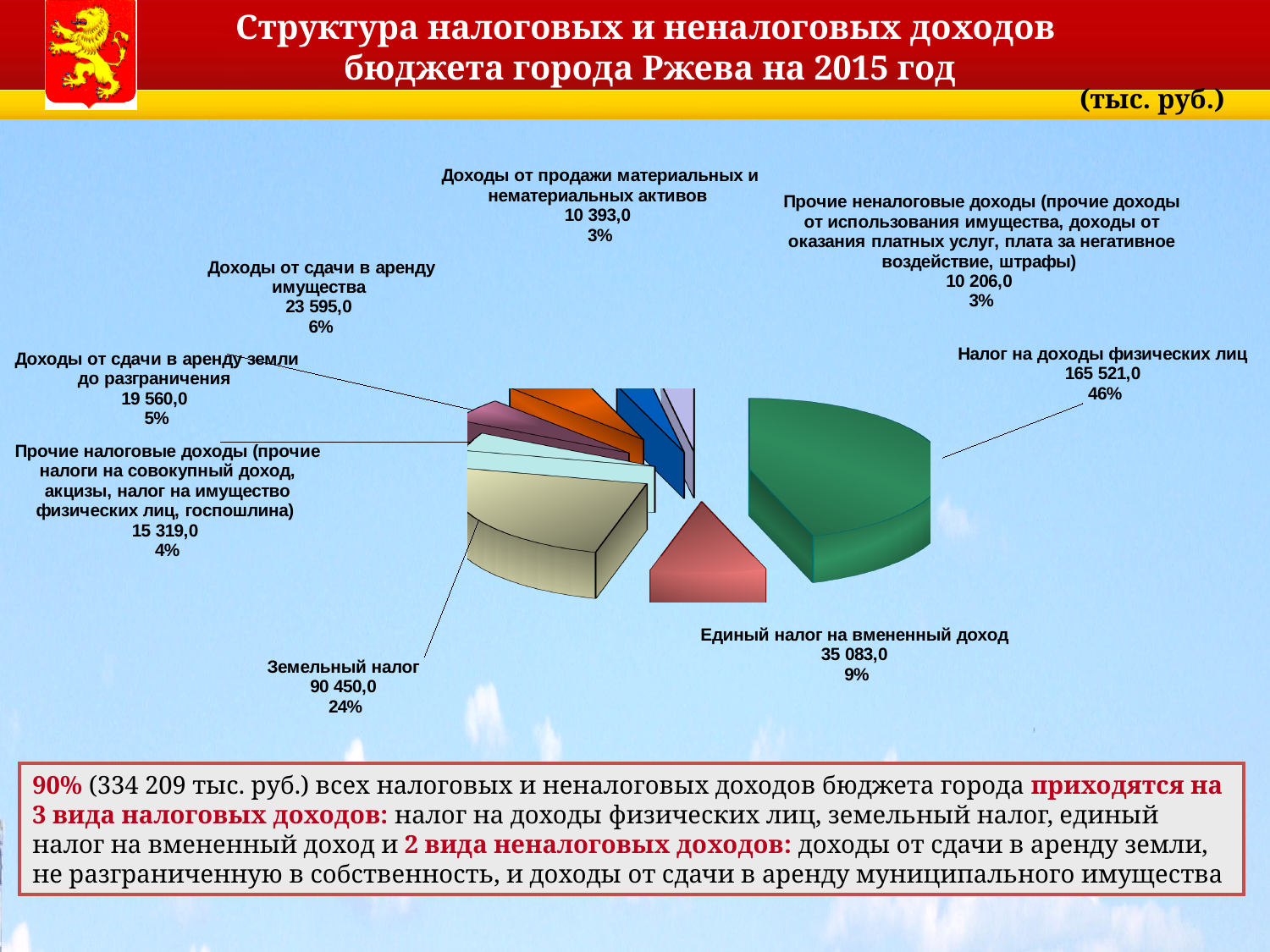
What type of chart is shown on the slide? pie chart Which is larger: «Доходы от сдачи в аренду земли до разграничения» or «Прочие налоговые доходы»? Доходы от сдачи в аренду земли до разграничения What share of the pie does «Земельный налог» represent? 24% What unit of measurement is indicated for the chart values? тыс. руб. How many slices (categories) does the pie chart have? 8 Which category has the largest share of the pie? Налог на доходы физических лиц What is the difference between «Налог на доходы физических лиц» and «Земельный налог»? 75 071,0 Which category has the smallest value in the pie chart? Прочие неналоговые доходы What is the value for «Доходы от сдачи в аренду имущества»? 23 595,0 What is the value for «Земельный налог»? 90 450,0 What is the value for «Налог на доходы физических лиц»? 165 521,0 What is the value for «Единый налог на вмененный доход»? 35 083,0